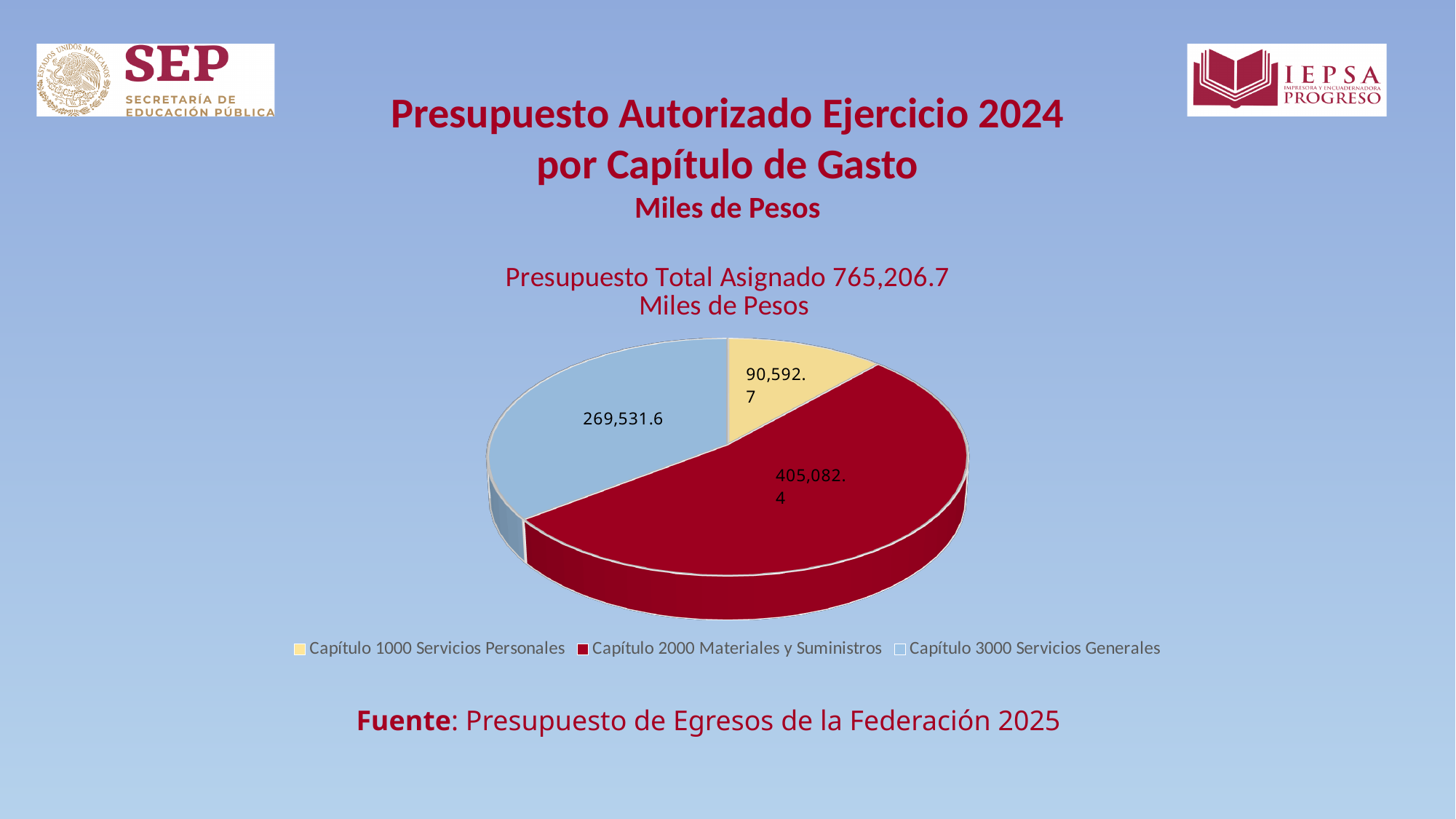
Which category has the largest slice of the pie? Capítulo 2000 Materiales y Suministros Which category has the smallest slice of the pie? Capítulo 1000 Servicios Personales How many slices does the pie chart have? 3 What is the difference between the values for Capítulo 2000 Materiales y Suministros and Capítulo 3000 Servicios Generales? 135,550.8 What total budget is stated in the chart title? 765,206.7 What share of the total does Capítulo 2000 Materiales y Suministros represent, to one decimal place? 52.9% Which is larger, the value for Capítulo 3000 Servicios Generales or Capítulo 1000 Servicios Personales? Capítulo 3000 Servicios Generales What is the value for Capítulo 2000 Materiales y Suministros? 405,082.4 What is the difference between the values for Capítulo 3000 Servicios Generales and Capítulo 1000 Servicios Personales? 178,938.9 What is the value for Capítulo 3000 Servicios Generales? 269,531.6 What kind of chart is shown on the slide? Pie chart What is the value for Capítulo 1000 Servicios Personales? 90,592.7